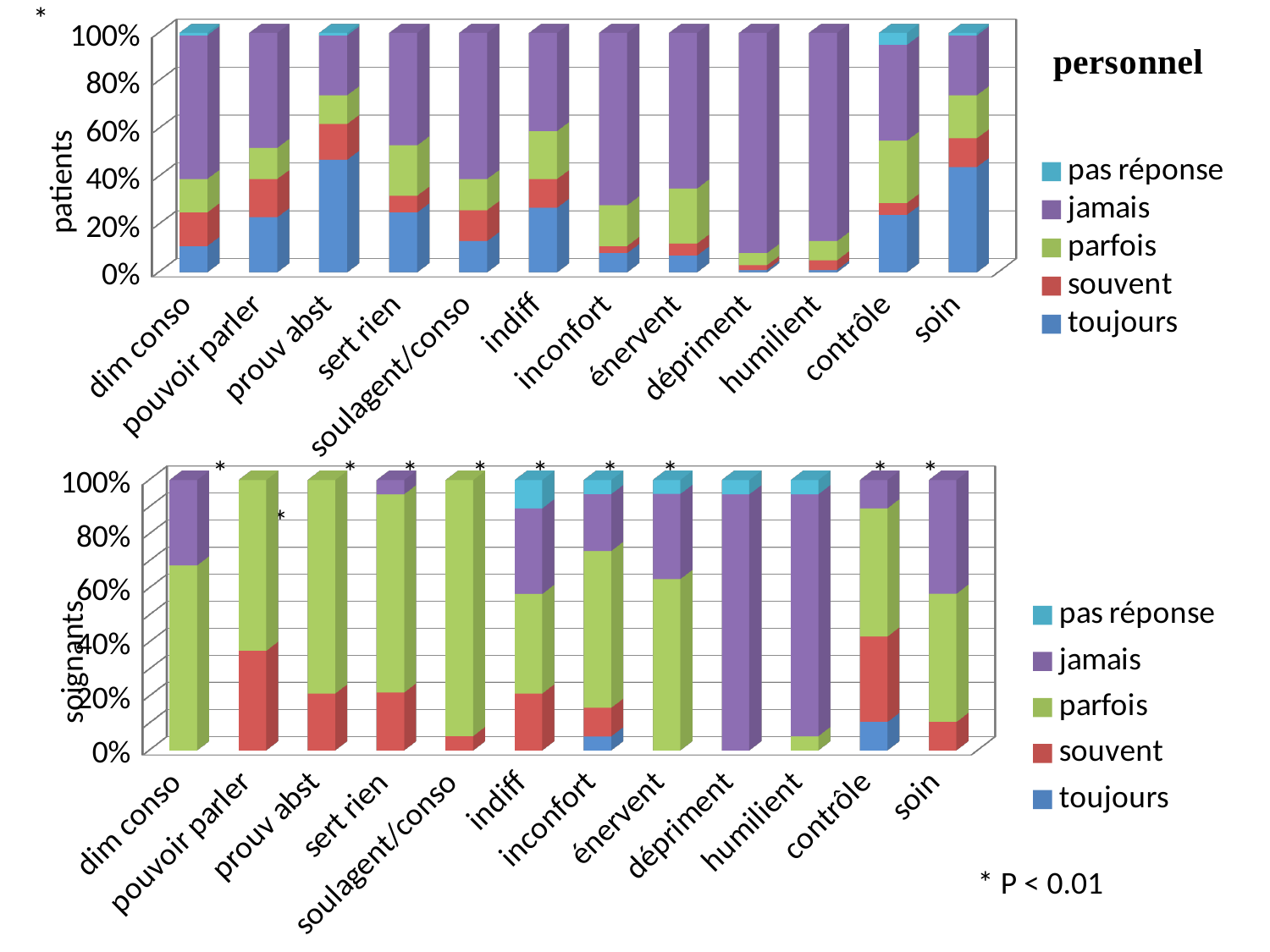
In the bottom chart (soignants), is the 'souvent' share for 'contrôle' greater or less than 20%? greater What kind of chart is the top chart (patients)? stacked bar chart How many series does the legend of the top chart (patients) list? 5 In the bottom chart (soignants), is the 'parfois' share for 'soulagent/conso' greater or less than 80%? greater In the top chart (patients), is the 'toujours' share for 'inconfort' greater or less than 20%? less How many categories are shown on the x axis of the bottom chart (soignants)? 12 In the bottom chart (soignants), which category has the largest 'parfois' segment? soulagent/conso What are the legend entries of the bottom chart (soignants)? pas réponse, jamais, parfois, souvent, toujours In the bottom chart (soignants), which has the larger 'jamais' segment: 'dépriment' or 'dim conso'? dépriment In the top chart (patients), which has the larger 'toujours' segment: 'prouv abst' or 'inconfort'? prouv abst What is the y-axis label of the top chart? patients